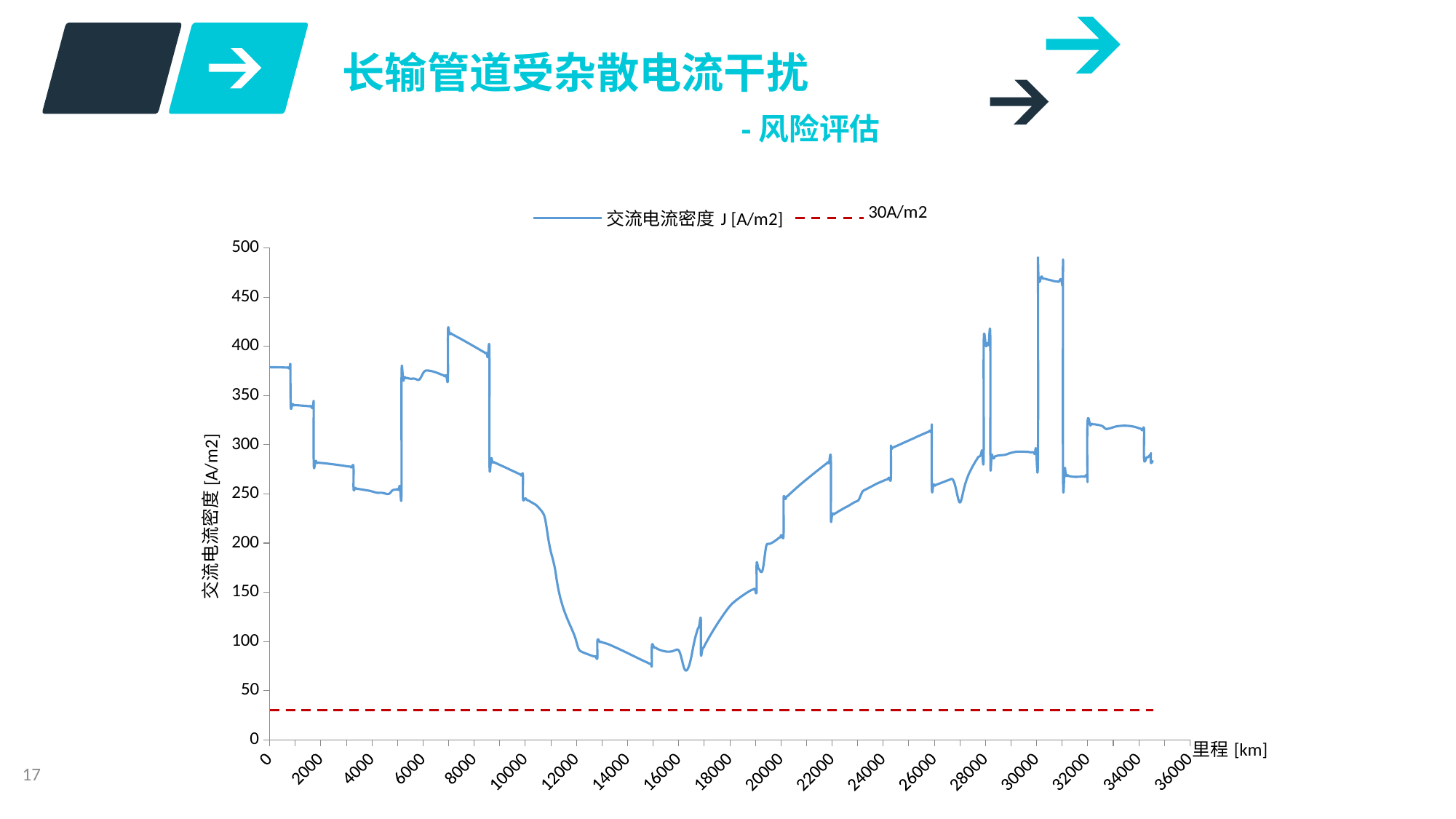
What are the two series named in the legend? 交流电流密度 J [A/m2] and 30A/m2 Does the 交流电流密度 line rise or fall between 8000 km and 16000 km? fall Is the highest value of the 交流电流密度 line greater or less than 450? greater Is the value of 交流电流密度 at 2000 km greater or less than 300? less How many series does the legend list? 2 What value does the red dashed line represent? 30A/m2 Is the value of 交流电流密度 at 4000 km greater or less than 200? greater Does the 交流电流密度 line rise or fall between 16000 km and 24000 km? rise What kind of chart is shown on the slide? line chart What is the label of the x axis? 里程 [km]